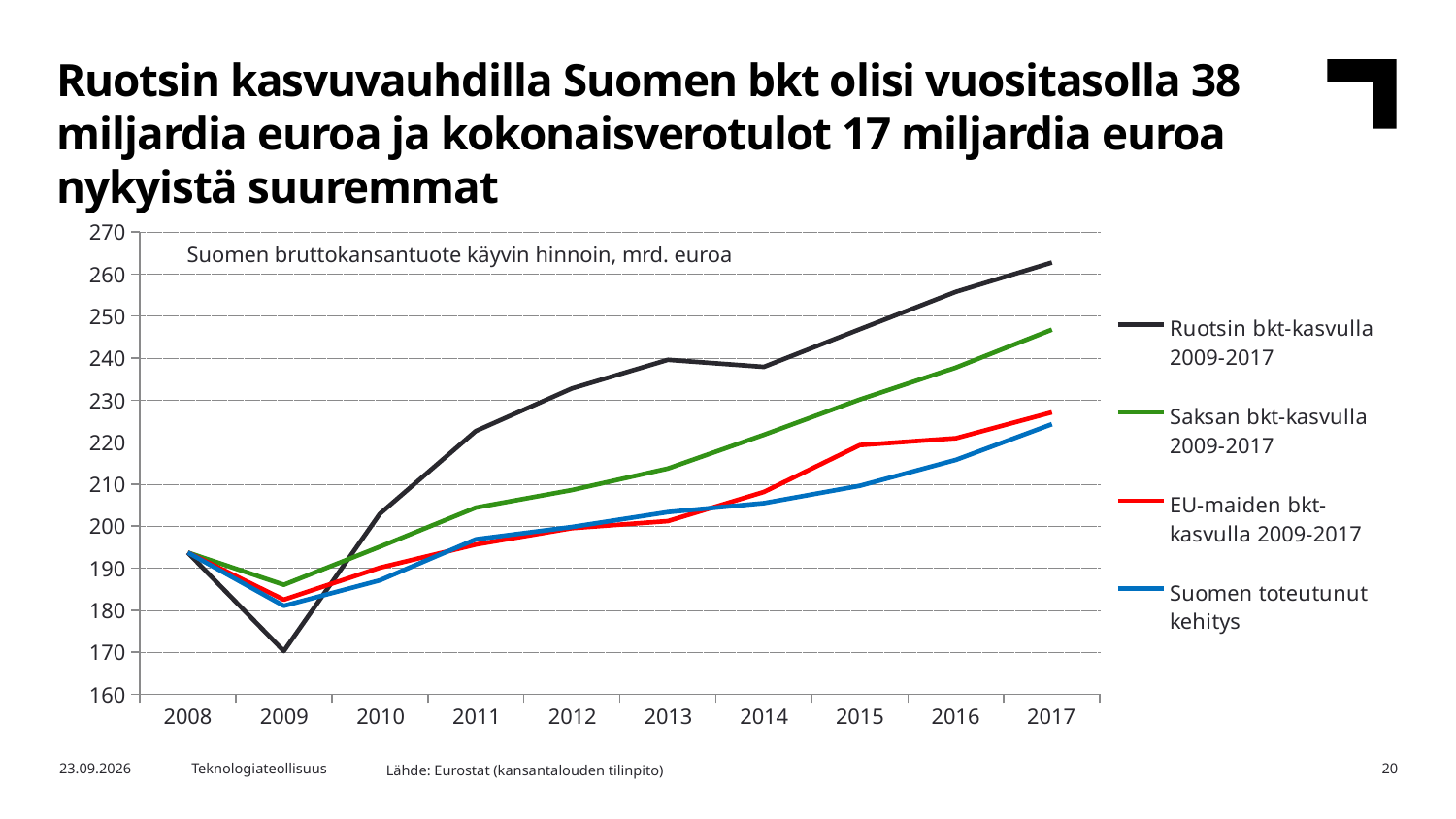
How many series does the legend list? 4 What kind of chart is shown on the slide? line chart Is the value for Saksan bkt-kasvulla 2009-2017 in 2009 greater or less than 190? less Is the value for Ruotsin bkt-kasvulla 2009-2017 in 2017 greater or less than 260? greater Which series has the highest value in 2017? Ruotsin bkt-kasvulla 2009-2017 What is the title shown inside the chart area? Suomen bruttokansantuote käyvin hinnoin, mrd. euroa What colour is the line for Suomen toteutunut kehitys? blue Is the value for Suomen toteutunut kehitys in 2017 greater or less than 220? greater In 2017, which is higher: Saksan bkt-kasvulla 2009-2017 or EU-maiden bkt-kasvulla 2009-2017? Saksan bkt-kasvulla 2009-2017 How many years are shown on the x axis? 10 Which series has the lowest value in 2009? Ruotsin bkt-kasvulla 2009-2017 Does the Ruotsin bkt-kasvulla 2009-2017 line rise or fall from 2009 to 2017? rise